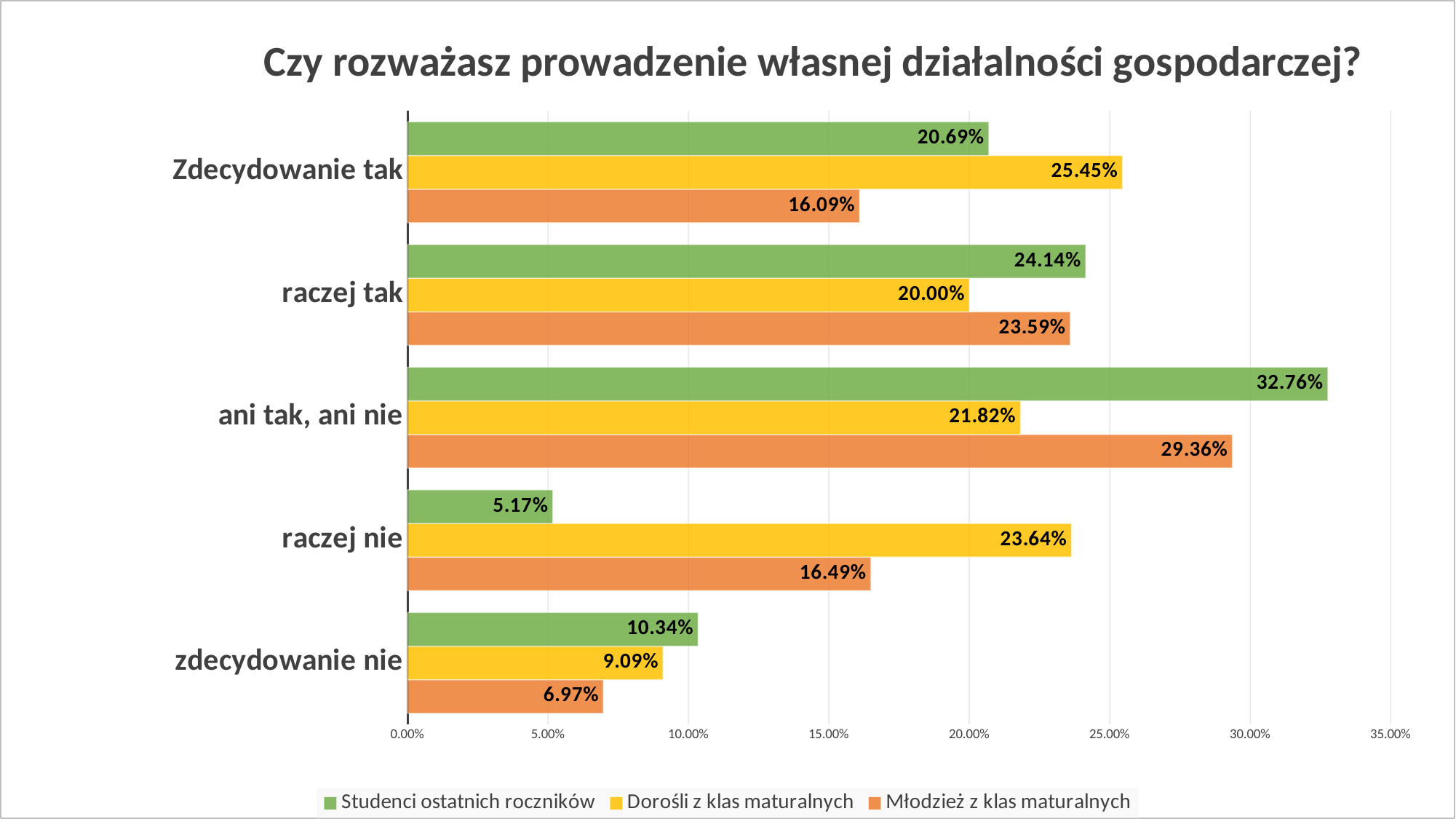
What is the title of the chart? Czy rozważasz prowadzenie własnej działalności gospodarczej? What is the value for 'Młodzież z klas maturalnych' in the 'raczej nie' category? 16.49% How many response categories are shown on the chart? 5 What is the value for 'Dorośli z klas maturalnych' in the 'Zdecydowanie tak' category? 25.45% How many series does the legend list? 3 What is the difference between 'Dorośli z klas maturalnych' and 'Młodzież z klas maturalnych' in the 'Zdecydowanie tak' category? 9.36% What is the value for 'Studenci ostatnich roczników' in the 'ani tak, ani nie' category? 32.76% What kind of chart is shown on the slide? Bar chart Is the value for 'Dorośli z klas maturalnych' in the 'raczej nie' category greater or less than 20.00%? greater In the 'raczej tak' category, which is larger: 'Studenci ostatnich roczników' or 'Dorośli z klas maturalnych'? Studenci ostatnich roczników Which category has the lowest value for 'Studenci ostatnich roczników'? raczej nie Which category has the highest value for 'Młodzież z klas maturalnych'? ani tak, ani nie